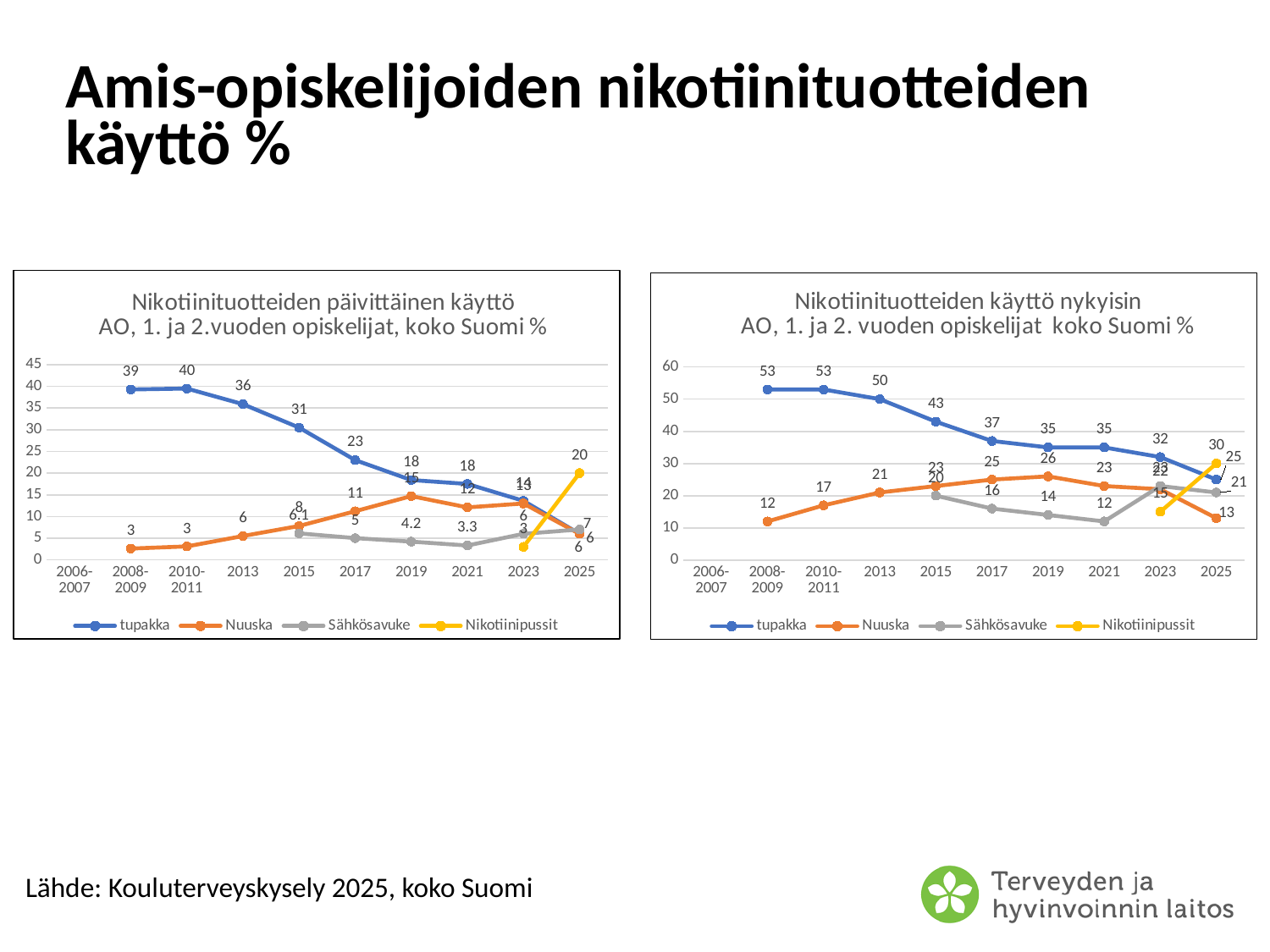
In the left chart (Nikotiinituotteiden päivittäinen käyttö), what is the difference between the tupakka values in 2008-2009 and 2025? 33 In the right chart (Nikotiinituotteiden käyttö nykyisin), what is the difference between the Sähkösavuke values in 2015 and 2021? 8 In the right chart (Nikotiinituotteiden käyttö nykyisin), does the tupakka series rise or fall from 2008-2009 to 2025? fall In the left chart (Nikotiinituotteiden päivittäinen käyttö), what is the value for tupakka in 2010-2011? 40 In the right chart (Nikotiinituotteiden käyttö nykyisin), what is the value for tupakka in 2013? 50 In the left chart (Nikotiinituotteiden päivittäinen käyttö), what is the value for Sähkösavuke in 2019? 4.2 In the right chart (Nikotiinituotteiden käyttö nykyisin), which is larger in 2025: Nikotiinipussit or Nuuska? Nikotiinipussit What type of chart is the right chart (Nikotiinituotteiden käyttö nykyisin)? line chart In the left chart (Nikotiinituotteiden päivittäinen käyttö), how many series does the legend list? 4 In the right chart (Nikotiinituotteiden käyttö nykyisin), what is the value for Nuuska in 2019? 26 In the left chart (Nikotiinituotteiden päivittäinen käyttö), what is the value for Nikotiinipussit in 2025? 20 In the left chart (Nikotiinituotteiden päivittäinen käyttö), which year has the highest value for tupakka? 2010-2011